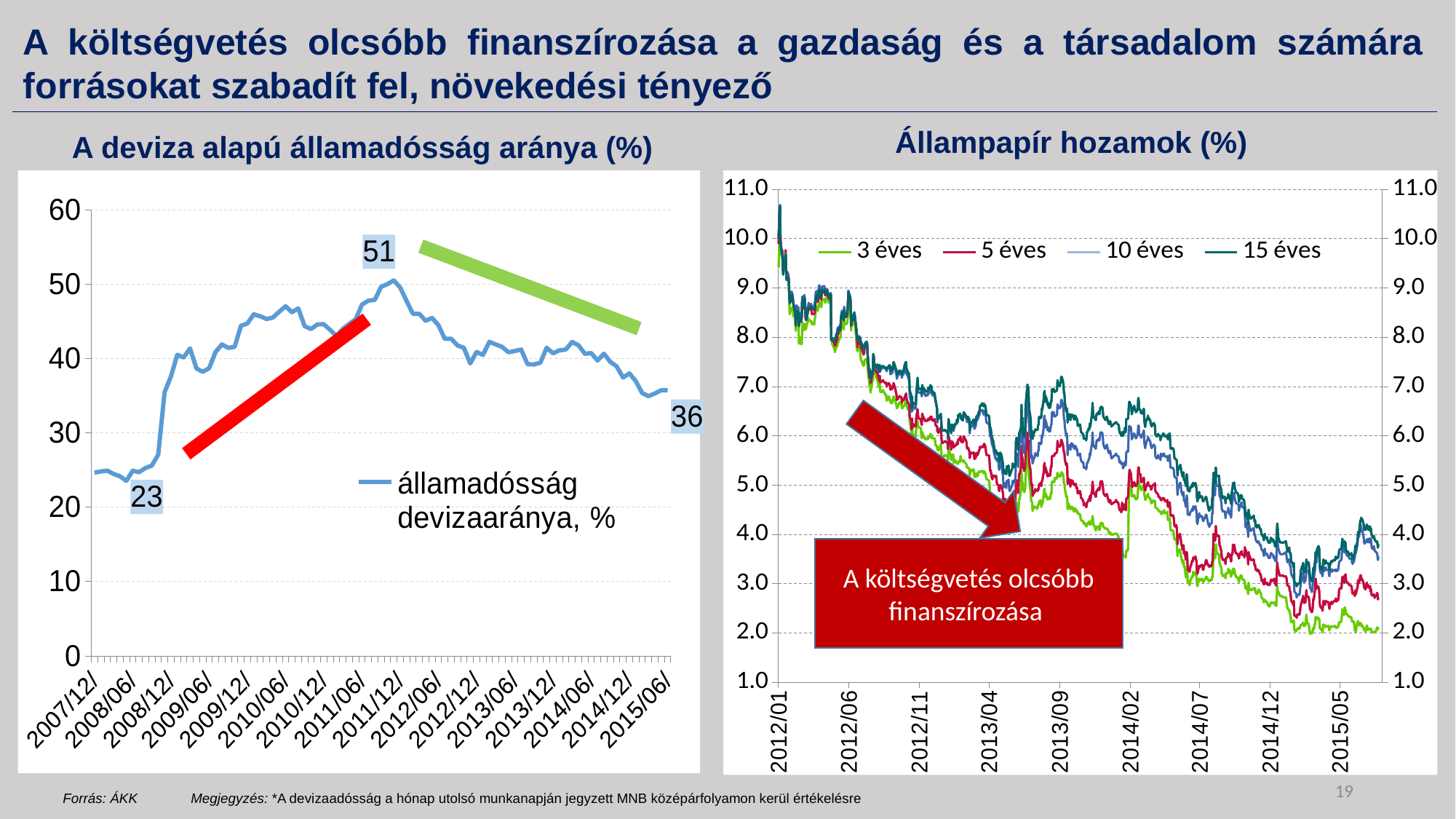
On the left chart 'A deviza alapú államadósság aránya (%)', is the value at 2009/12 greater or less than 40? greater On the left chart 'A deviza alapú államadósság aránya (%)', does the value rise or fall between 2011/12 and 2015/06? fall On the left chart 'A deviza alapú államadósság aránya (%)', what is the difference between the labelled peak value and the labelled starting value of 23? 28 On the right chart 'Állampapír hozamok (%)', do the yields generally rise or fall from 2012/01 to 2015/05? fall On the left chart 'A deviza alapú államadósság aránya (%)', what value is labelled at the end of the series in 2015? 36 On the left chart 'A deviza alapú államadósság aránya (%)', what is the difference between the labelled peak value and the labelled final value? 15 On the left chart 'A deviza alapú államadósság aránya (%)', what is the peak value labelled on the line? 51 What kind of chart is the left chart 'A deviza alapú államadósság aránya (%)'? line chart On the right chart 'Állampapír hozamok (%)', is the value of the 3 éves series at 2015/05 greater or less than 3.0? less On the left chart 'A deviza alapú államadósság aránya (%)', what value is labelled at the start of the series near 2008? 23 On the right chart 'Állampapír hozamok (%)', how many series does the legend list? 4 On the right chart 'Állampapír hozamok (%)', which series has the lowest value at the end of the period? 3 éves